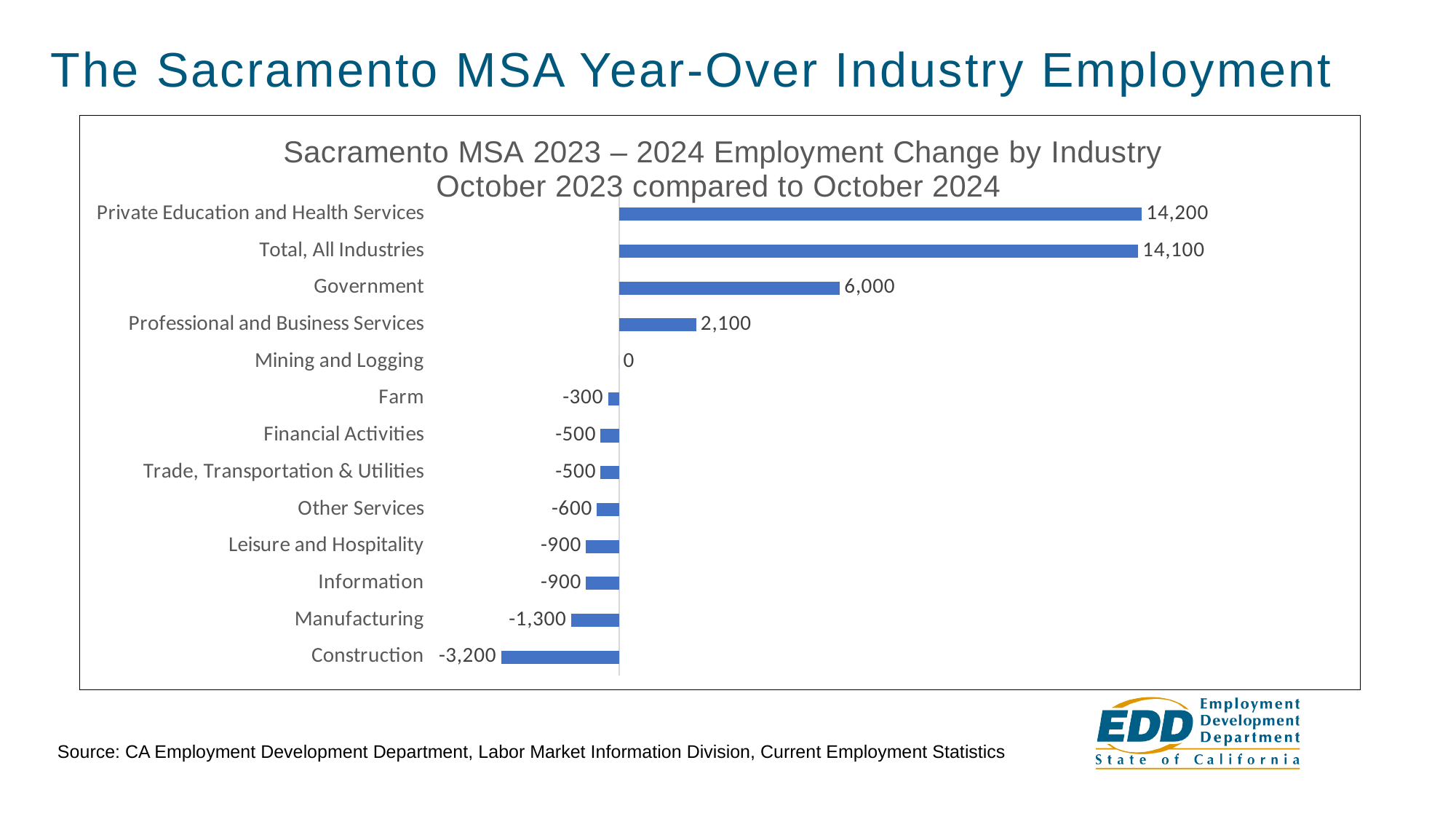
What is the difference between the employment change for Private Education and Health Services and for Government? 8,200 What is the difference between the employment change for Manufacturing and for Construction? 1,900 What is the title of the chart? Sacramento MSA 2023 – 2024 Employment Change by Industry October 2023 compared to October 2024 How many categories are shown in the chart? 13 Which industry has the lowest employment change? Construction Which industry has the highest employment change? Private Education and Health Services Which has a larger employment change, Government or Professional and Business Services? Government What is the employment change for Government? 6,000 What is the employment change for Construction? -3,200 What kind of chart is shown on the slide? Bar chart What is the employment change for Mining and Logging? 0 What is the employment change for Professional and Business Services? 2,100